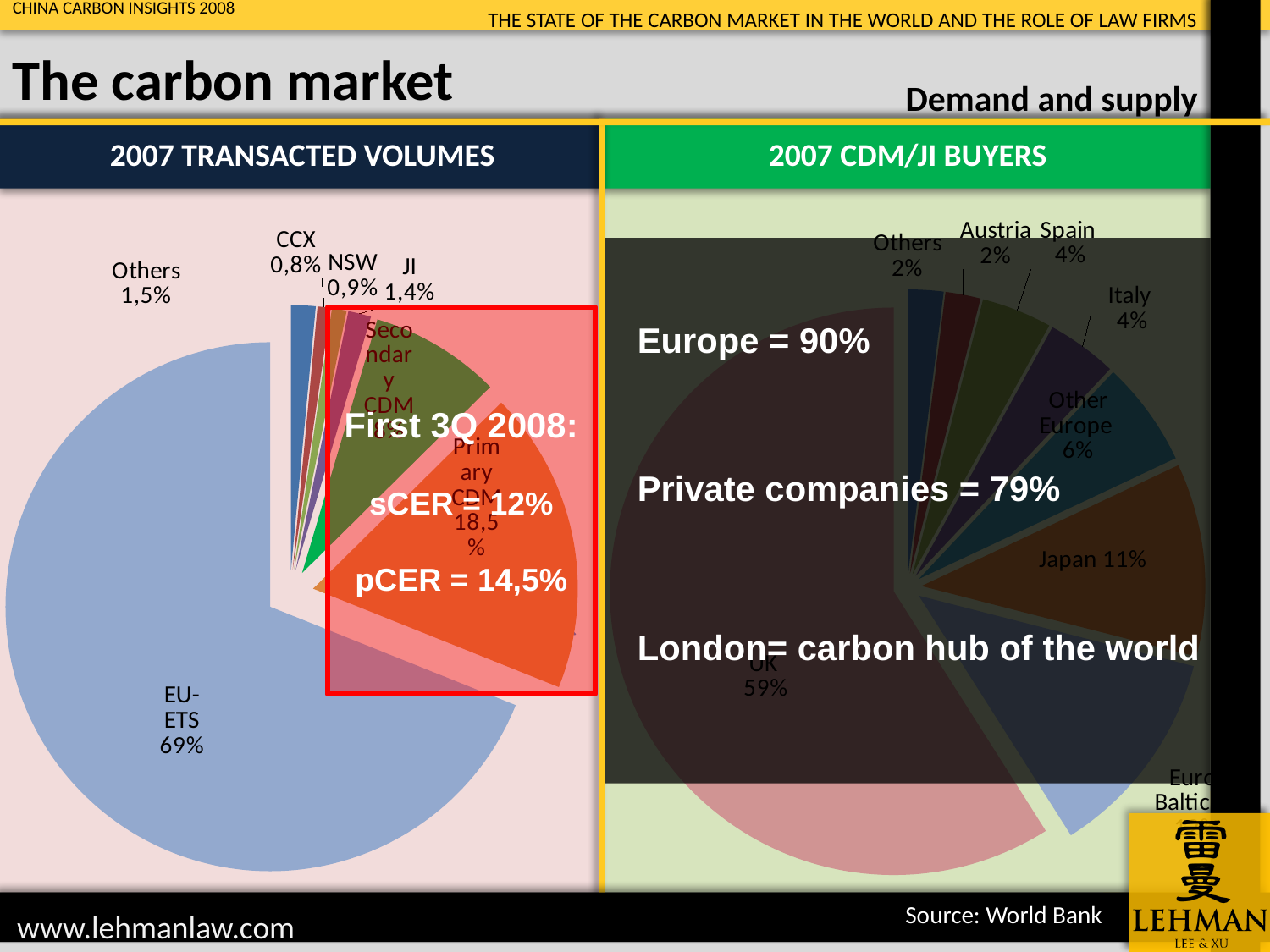
What kind of chart is the '2007 TRANSACTED VOLUMES' chart? Pie chart In the '2007 TRANSACTED VOLUMES' chart, which category has the largest share? EU-ETS In the '2007 TRANSACTED VOLUMES' chart, what share does JI have? 1,4% In the '2007 TRANSACTED VOLUMES' chart, how many percentage points larger is EU-ETS than Primary CDM? 50,5% In the '2007 TRANSACTED VOLUMES' chart, what share does EU-ETS have? 69% In the '2007 CDM/JI BUYERS' chart, what share does the UK have? 59% In the '2007 CDM/JI BUYERS' chart, how many percentage points larger is the UK share than Japan's? 48% In the '2007 TRANSACTED VOLUMES' chart, which has the larger share, NSW or CCX? NSW In the '2007 CDM/JI BUYERS' chart, which buyer has the largest share? UK In the '2007 CDM/JI BUYERS' chart, which has the larger share, Italy or Other Europe? Other Europe In the '2007 CDM/JI BUYERS' chart, what share does Japan have? 11% In the '2007 TRANSACTED VOLUMES' chart, what share does Primary CDM have? 18,5%